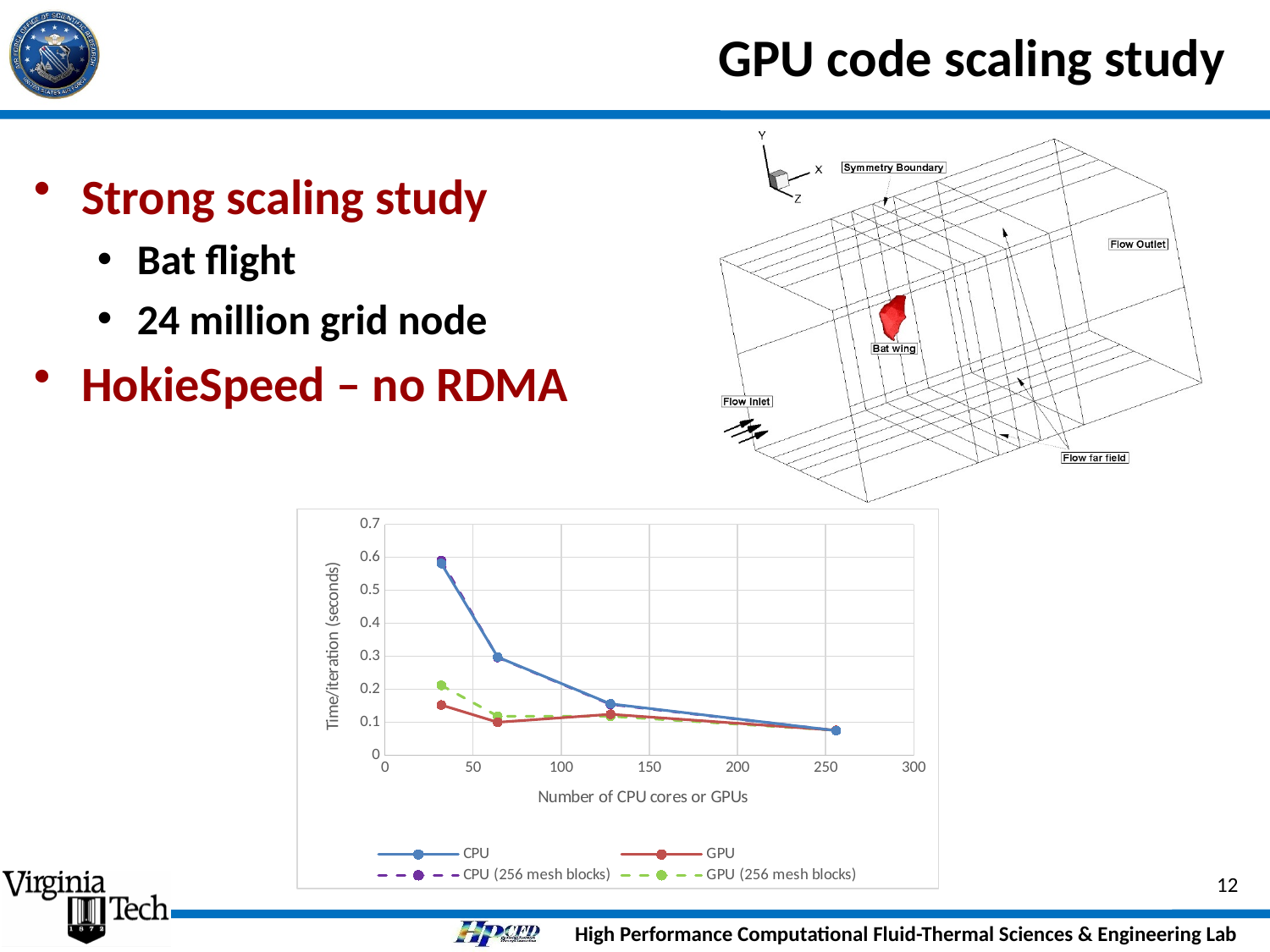
Is the time per iteration for the CPU series at its leftmost point (around 32 cores) greater or less than 0.5 seconds? greater How many data points are plotted for the CPU series? 4 Is the time per iteration for the CPU series at around 128 cores greater or less than 0.1 seconds? greater Is the time per iteration for the GPU series at its leftmost point (around 32 GPUs) greater or less than 0.2 seconds? less What is the label of the y axis of the chart? Time/iteration (seconds) How many series does the chart legend list? 4 What kind of chart is shown on the slide? line chart What is the label of the x axis of the chart? Number of CPU cores or GPUs Does the time per iteration for the CPU series rise or fall as the number of CPU cores increases? fall At the leftmost data point (around 32), which series has the higher time per iteration, CPU or GPU? CPU